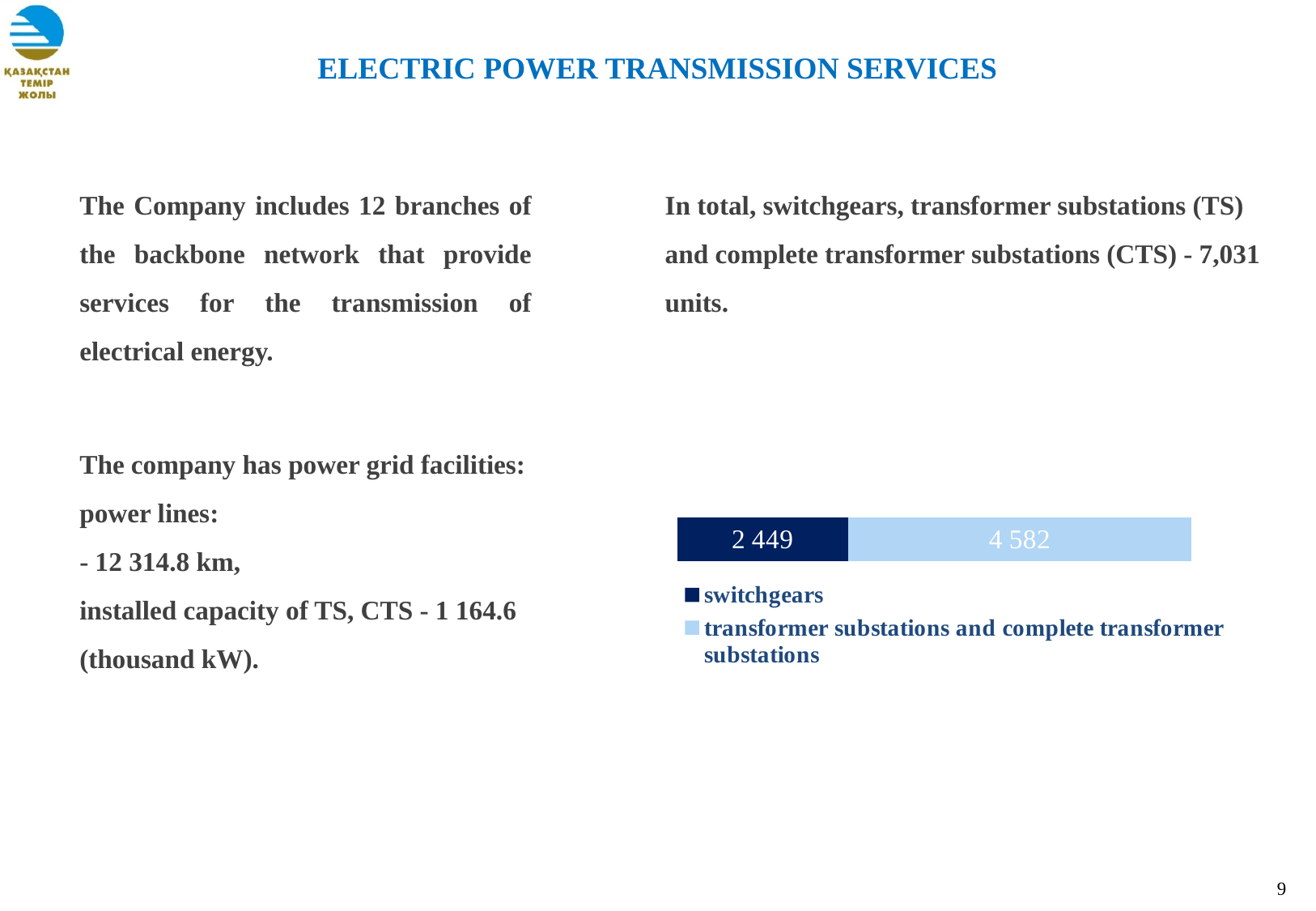
What is the difference between the transformer substations and complete transformer substations value and the switchgears value in the stacked bar chart? 2 133 What value is shown for transformer substations and complete transformer substations in the stacked bar chart? 4 582 What value is shown for switchgears in the stacked bar chart? 2 449 Which series has the largest value in the stacked bar chart? transformer substations and complete transformer substations What is the total of the stacked bar in the chart? 7 031 What kind of chart is shown on the slide? stacked bar chart Which colour represents switchgears in the stacked bar chart? dark blue Which colour represents transformer substations and complete transformer substations in the stacked bar chart? light blue Which series has the larger value in the stacked bar chart, switchgears or transformer substations and complete transformer substations? transformer substations and complete transformer substations How many series does the legend of the stacked bar chart list? 2 Which series has the smallest value in the stacked bar chart? switchgears